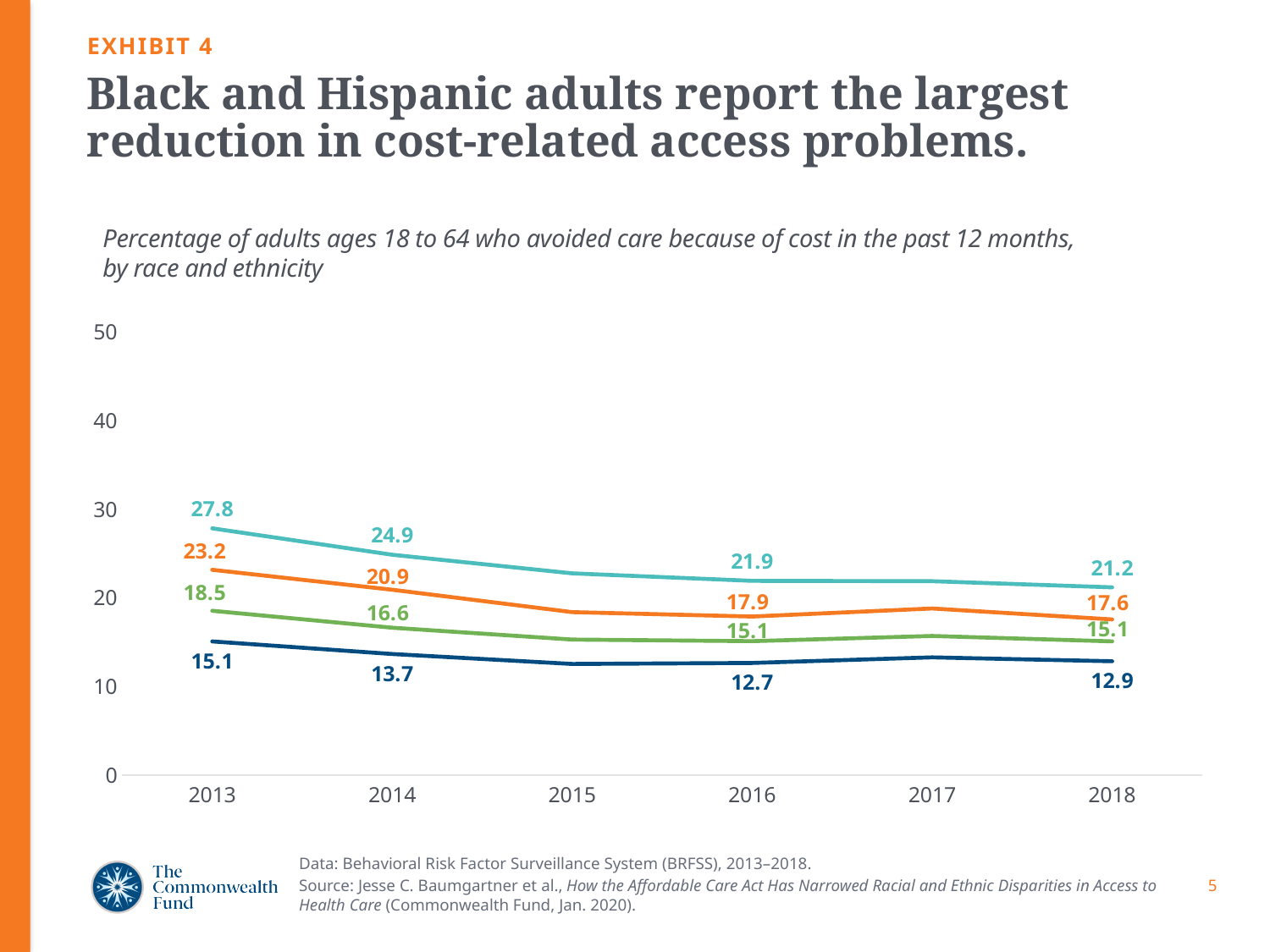
What is the value of the green line in 2014? 16.6 In which year does the teal line reach its highest value? 2013 By how much did the orange line fall from 2013 to 2018? 5.6 How many lines are plotted on the chart? 4 What is the value of the bottom (dark blue) line in 2016? 12.7 Is the value of the teal line in 2015 greater or less than 20? greater What is the lowest labelled value on the chart? 12.7 What kind of chart is shown on the slide? line chart In 2018, which is larger: the green line or the dark blue line? green line What is the value of the top (teal) line in 2013? 27.8 How many years are shown along the x axis of the chart? 6 By how much did the teal line fall from 2013 to 2018? 6.6